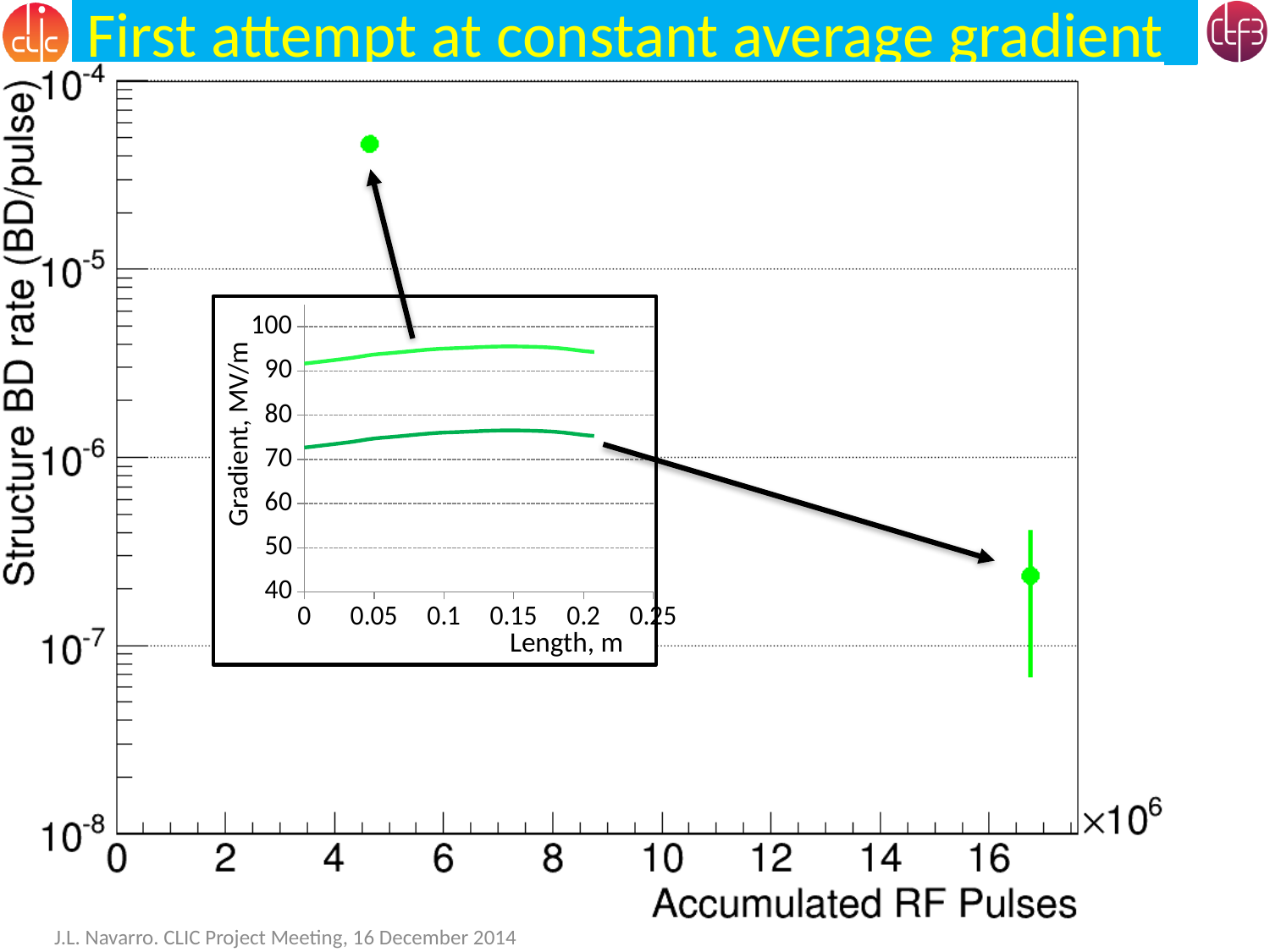
In the main chart, is the Structure BD rate of the point near 4.6 million accumulated RF pulses greater or less than 10^-5? greater In the main chart, does the Structure BD rate rise or fall as Accumulated RF Pulses increase? fall What kind of chart is the inset chart labelled Gradient, MV/m versus Length, m? line chart In the inset chart, how many lines are plotted? 2 In the main chart, how many data points are plotted? 2 In the main chart, is the Structure BD rate of the point near 17 million accumulated RF pulses greater or less than 10^-6? less What is the x-axis label of the main chart? Accumulated RF Pulses In the inset chart, is the gradient of the lower (dark green) line greater or less than 80 MV/m? less What kind of chart is the main chart of Structure BD rate versus Accumulated RF Pulses? scatter plot In the main chart, which point has the higher Structure BD rate: the one near 4.6 million pulses or the one near 17 million pulses? the one near 4.6 million pulses